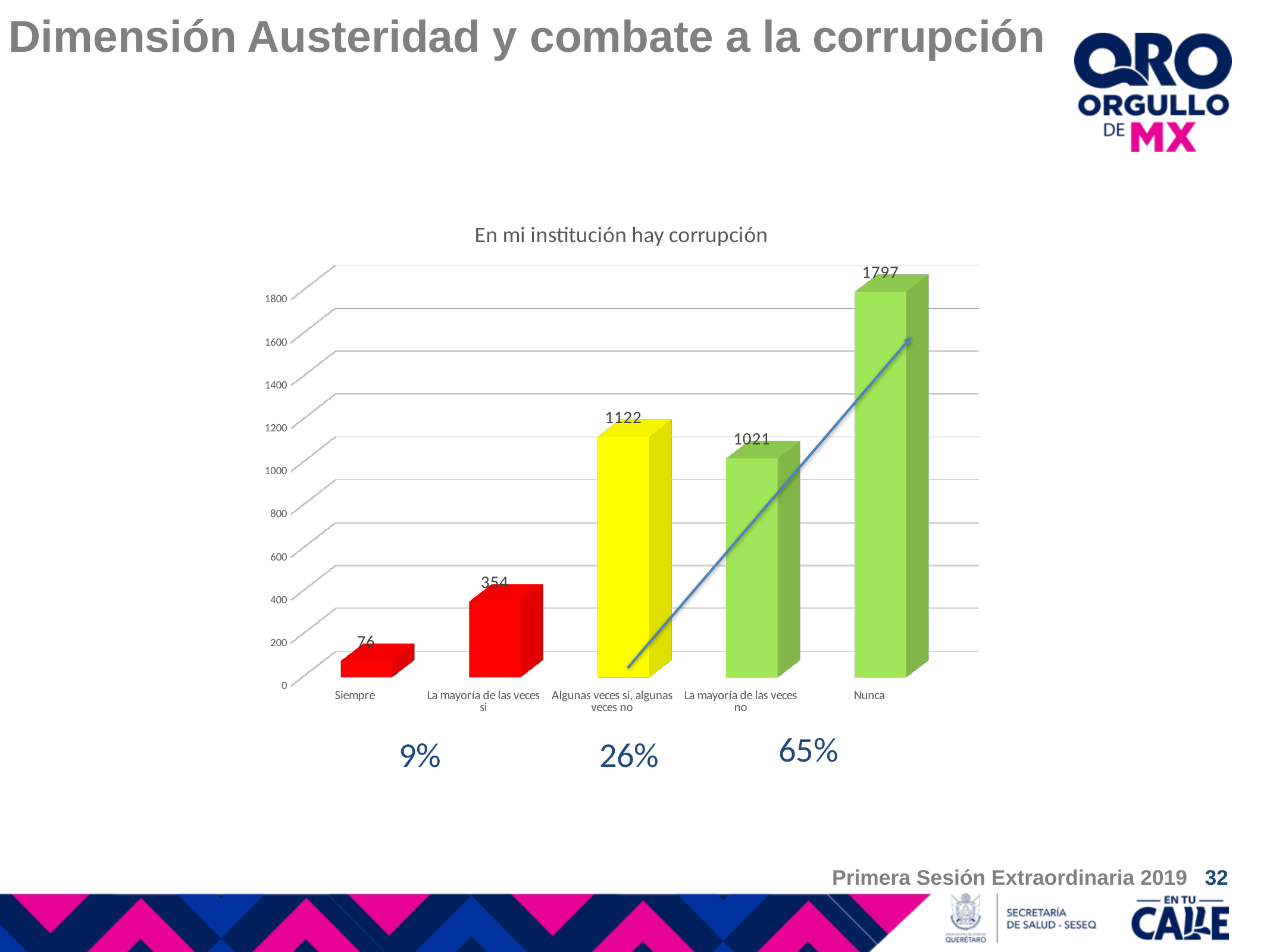
Which is larger, the value for La mayoría de las veces si or the value for La mayoría de las veces no? La mayoría de las veces no Which category has the highest value? Nunca What is the difference between the values for Algunas veces si, algunas veces no and La mayoría de las veces no? 101 What is the title of the chart? En mi institución hay corrupción Which category has the lowest value? Siempre What kind of chart is shown on the slide? Bar chart What is the difference between the values for Nunca and Siempre? 1721 What is the value for La mayoría de las veces si? 354 What is the value for Algunas veces si, algunas veces no? 1122 What is the value for Nunca? 1797 What is the value for Siempre? 76 How many categories are shown on the x axis? 5